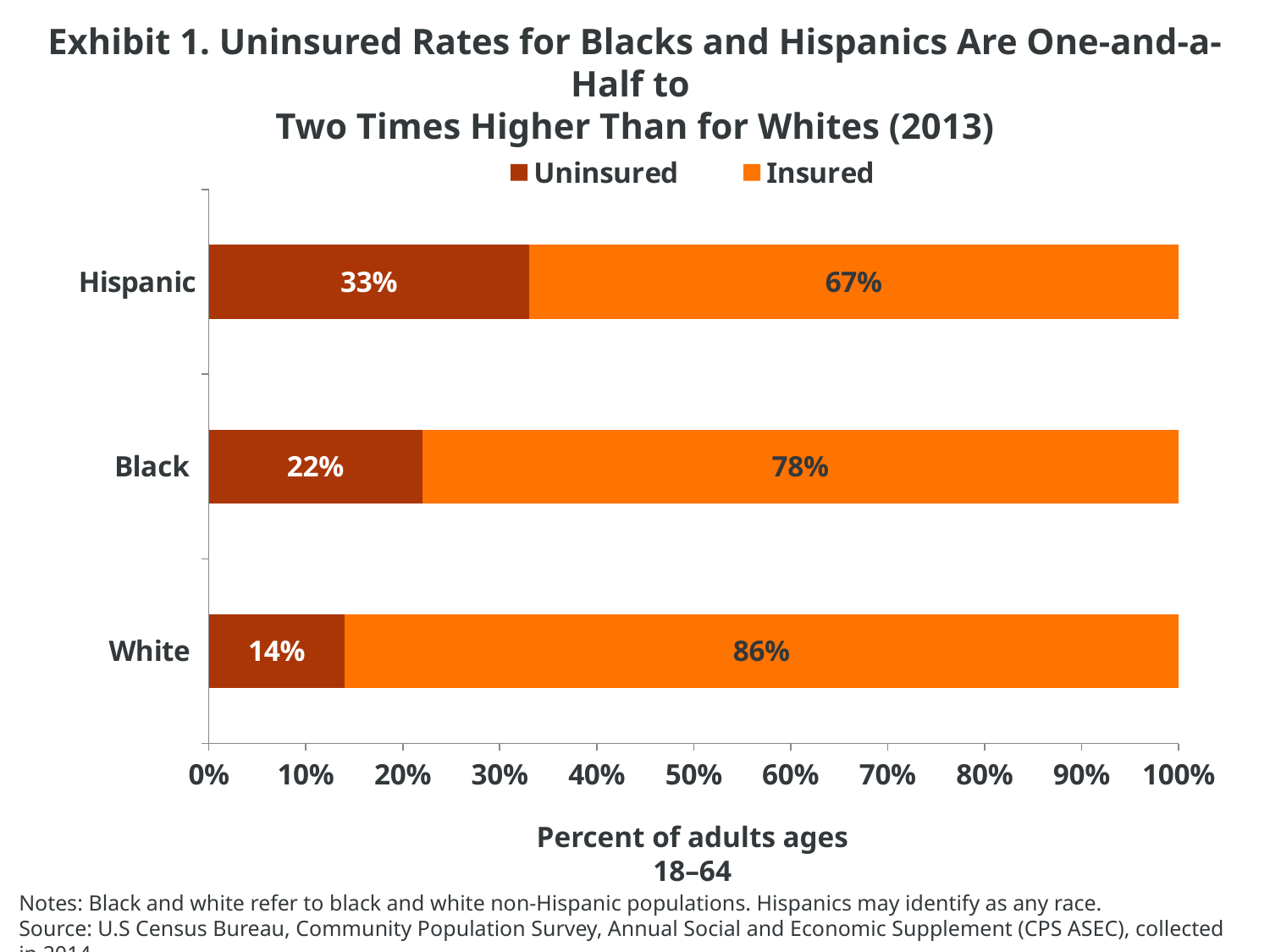
How many groups are shown on the chart? 3 Which group has the highest uninsured rate? Hispanic What kind of chart is shown? Stacked bar chart How many series does the legend list? 2 Which group has the lowest uninsured rate? White What is the uninsured rate for Hispanic adults? 33% Which group has a higher insured rate, Black or Hispanic? Black What is the uninsured rate for White adults? 14% What is the insured rate for Black adults? 78% What is the x-axis label of the chart? Percent of adults ages 18–64 What is the difference between the uninsured rates for Hispanic and White adults? 19% What is the total of the Black bar (uninsured plus insured)? 100%